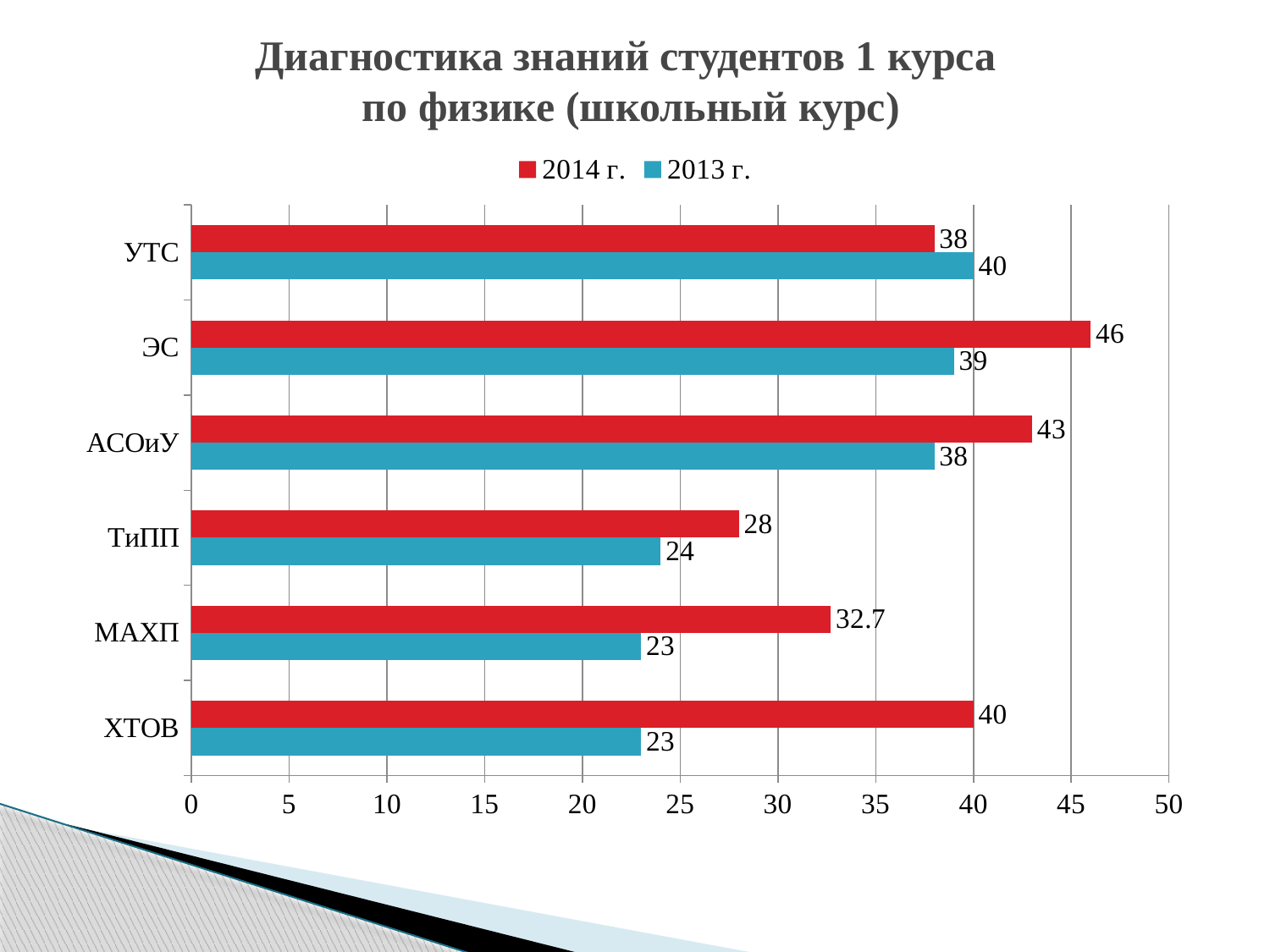
How many series does the legend list? 2 How many categories are shown on the chart? 6 What is the value for ЭС in the 2014 г. series? 46 What is the value for МАХП in the 2013 г. series? 23 Which category has the highest value in the 2014 г. series? ЭС Which category has the lowest value in the 2013 г. series? ХТОВ and МАХП (both 23) What is the value for МАХП in the 2014 г. series? 32.7 Is the 2014 г. value for АСОиУ greater or less than 40? greater What kind of chart is shown on the slide? bar chart What is the difference between the 2014 г. and 2013 г. values for ХТОВ? 17 Which is larger for УТС: the 2014 г. value or the 2013 г. value? 2013 г. What colour are the bars for the 2013 г. series? blue